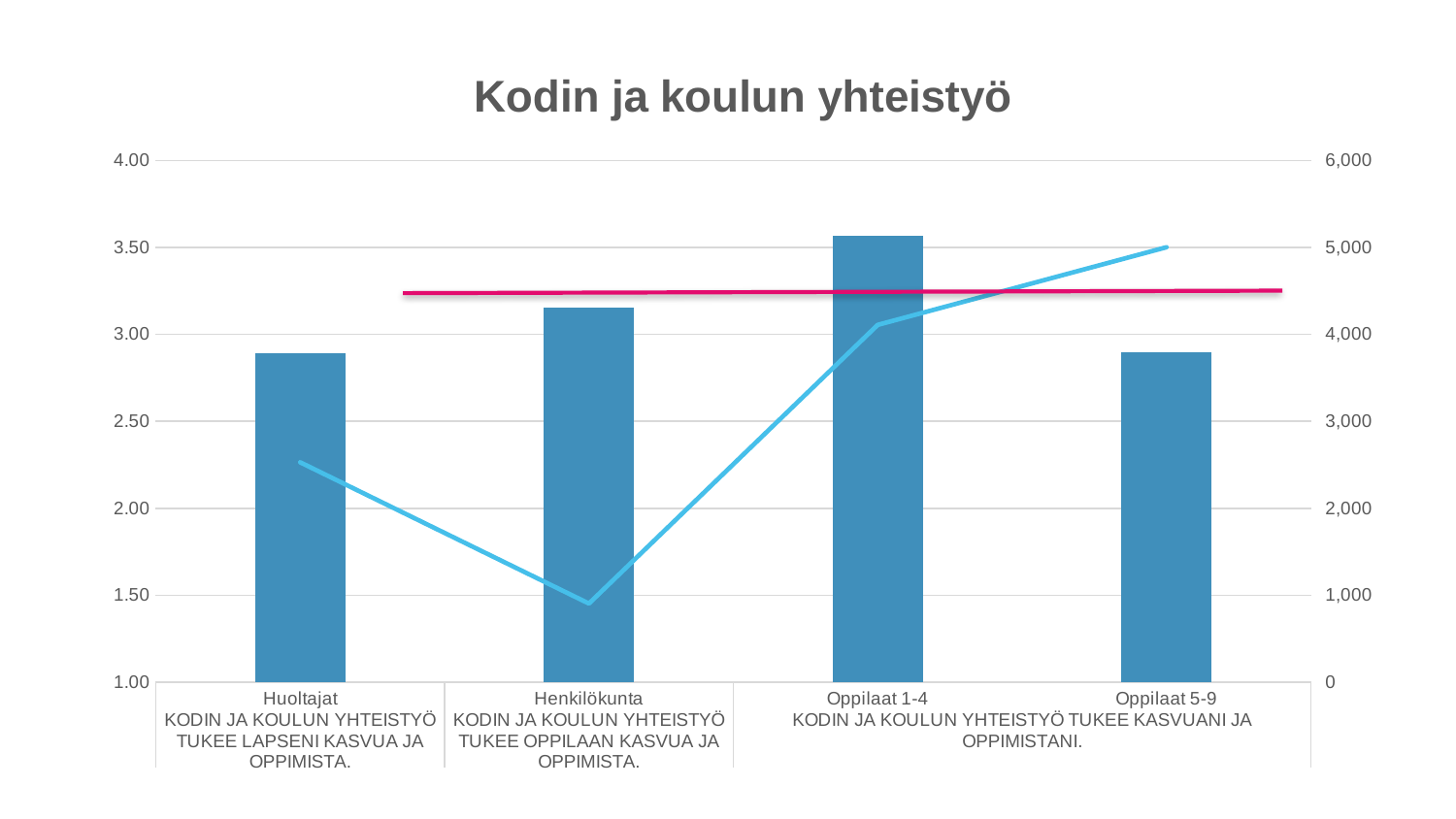
What kind of chart is shown on the slide? A combined bar and line chart Is the light blue line value for Oppilaat 5-9 greater or less than 4,000 on the right axis? greater Which has the taller bar, Huoltajat or Henkilökunta? Henkilökunta At which category does the light blue line reach its highest point? Oppilaat 5-9 Does the light blue line rise or fall from Henkilökunta to Oppilaat 5-9? rise Is the bar value for Oppilaat 1-4 greater or less than 3.50 on the left axis? greater How many categories are shown on the x axis? 4 Is the bar value for Huoltajat greater or less than 3.00 on the left axis? less Which category has the tallest bar? Oppilaat 1-4 At which category does the light blue line reach its lowest point? Henkilökunta What is the title of the chart? Kodin ja koulun yhteistyö